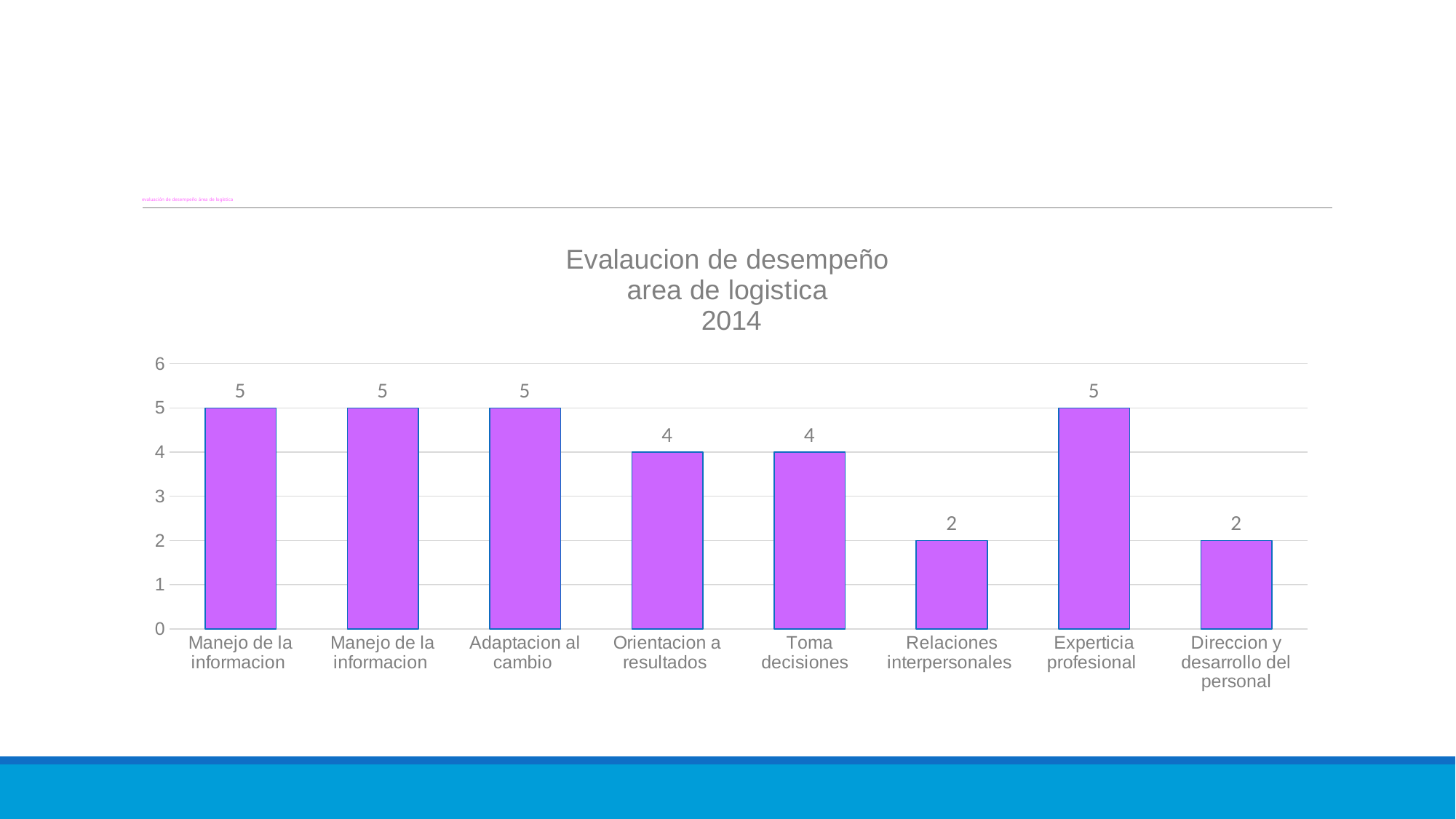
What is the value for Adaptacion al cambio? 5 What is the value for Orientacion a resultados? 4 What type of chart is shown on the slide? bar chart Is the value for Toma decisiones greater or less than 3? greater What is the value for Relaciones interpersonales? 2 What is the difference between the values for Toma decisiones and Relaciones interpersonales? 2 What is the maximum value shown on the y axis of the chart? 6 How many categories are shown on the x axis of the chart? 8 Which is larger, the value for Experticia profesional or the value for Direccion y desarrollo del personal? Experticia profesional What is the value for Experticia profesional? 5 What is the value for Direccion y desarrollo del personal? 2 What is the title of the chart? Evalaucion de desempeño area de logistica 2014